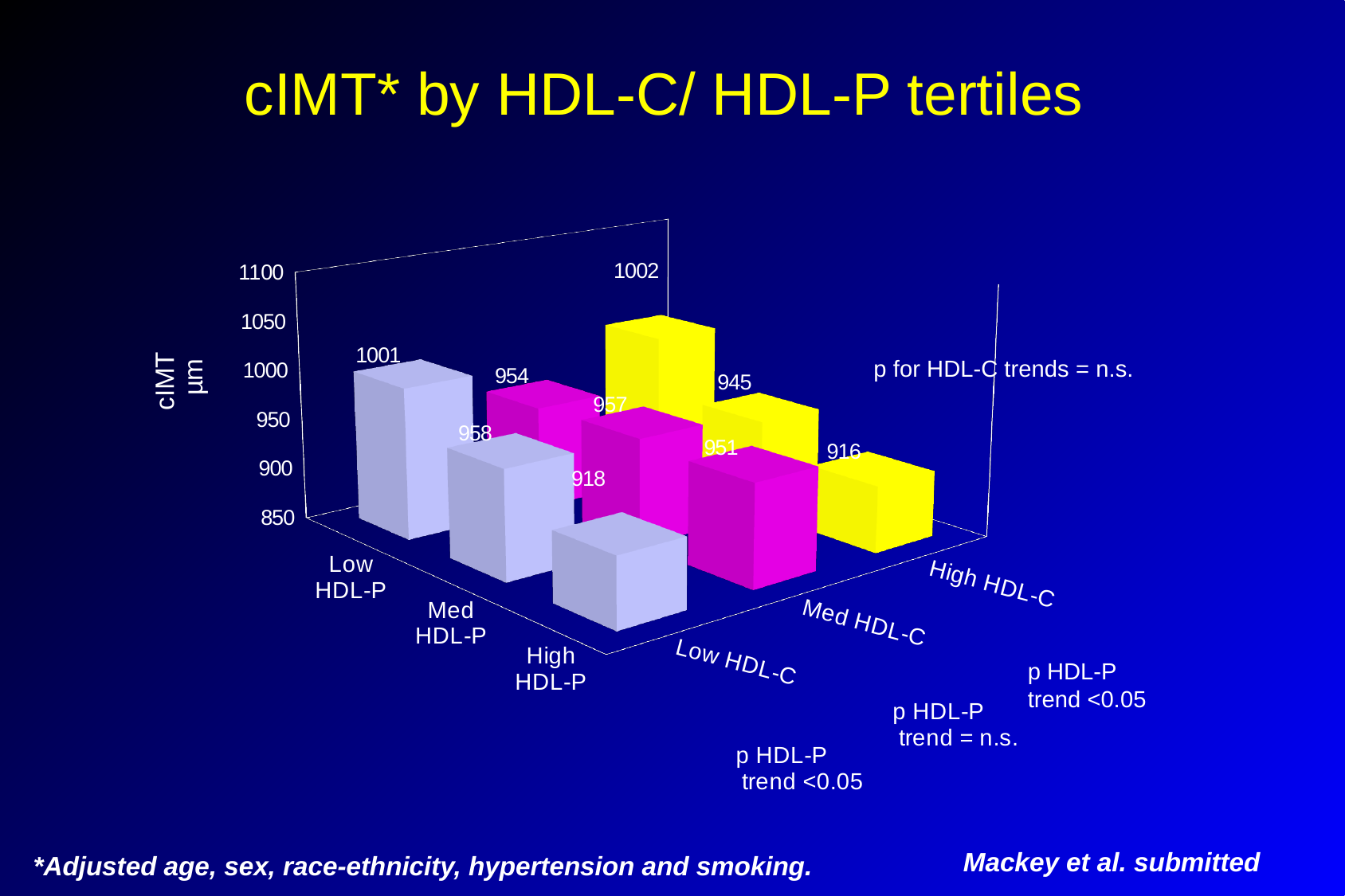
What is the cIMT value for Med HDL-P in the Med HDL-C group? 957 What is the cIMT value for Low HDL-P in the Low HDL-C group? 1001 Within the High HDL-C group, which is larger: the cIMT for Low HDL-P or for Med HDL-P? Low HDL-P Within the Low HDL-C group, does cIMT rise or fall as HDL-P goes from Low to High? fall Which bar has the lowest cIMT value on the chart? High HDL-P, High HDL-C (916) What is the label on the vertical axis of the chart? cIMT µm What is the cIMT value for High HDL-P in the High HDL-C group? 916 Which bar has the highest cIMT value on the chart? Low HDL-P, High HDL-C (1002) What kind of chart is shown on the slide? 3D bar chart How many bars are plotted on the chart? 9 What is the cIMT value for Med HDL-P in the High HDL-C group? 945 What is the difference in cIMT between Low HDL-P and High HDL-P within the Low HDL-C group? 83